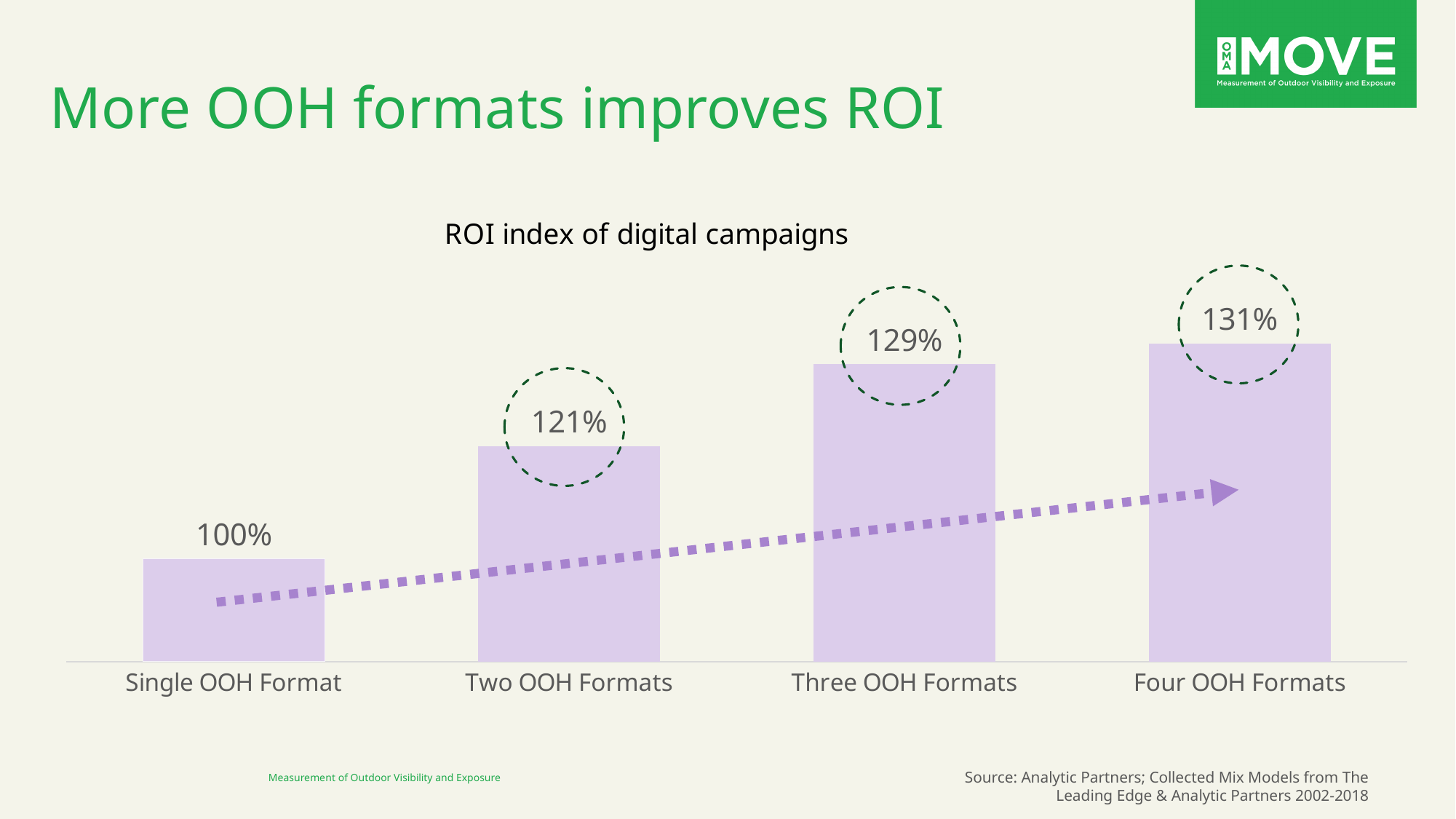
What is the ROI index for Four OOH Formats? 131% What is the ROI index for Single OOH Format? 100% How many categories are shown in the chart? 4 Do the ROI index values rise or fall as the number of OOH formats increases? Rise What is the ROI index for Three OOH Formats? 129% Which category has the lowest ROI index? Single OOH Format What is the difference in ROI index between Three OOH Formats and Two OOH Formats? 8% Which category has the highest ROI index? Four OOH Formats What kind of chart is shown on the slide? Bar chart Which has a higher ROI index, Two OOH Formats or Three OOH Formats? Three OOH Formats What is the ROI index for Two OOH Formats? 121% What is the difference in ROI index between Four OOH Formats and Single OOH Format? 31%